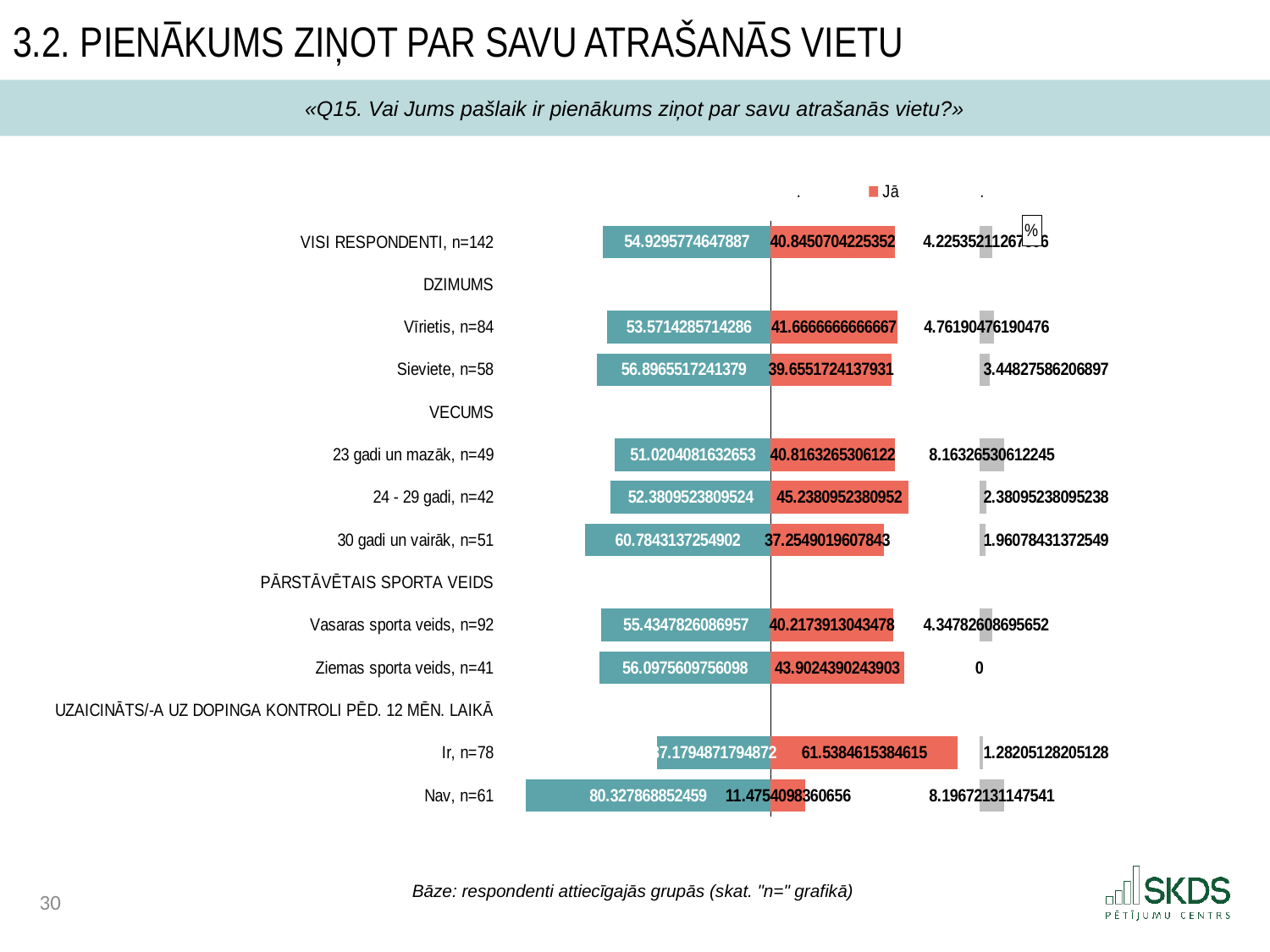
What is the value of the teal bar for Nav, n=61? 80.327868852459 What is the "Jā" value for 24 - 29 gadi, n=42? 45.2380952380952 What is the "Jā" value for Vīrietis, n=84? 41.6666666666667 How many groups have bars plotted in the chart? 10 What is the value of the grey bar for Ziemas sporta veids, n=41? 0 What kind of chart is shown on the slide? bar chart Which has the larger "Jā" value: Sieviete, n=58 or Ziemas sporta veids, n=41? Ziemas sporta veids, n=41 What colour are the "Jā" bars in the chart? red What is the "Jā" value for Nav, n=61? 11.4754098360656 Which group has the highest "Jā" value? Ir, n=78 Which group has the longest teal bar? Nav, n=61 Which group has the lowest "Jā" value? Nav, n=61